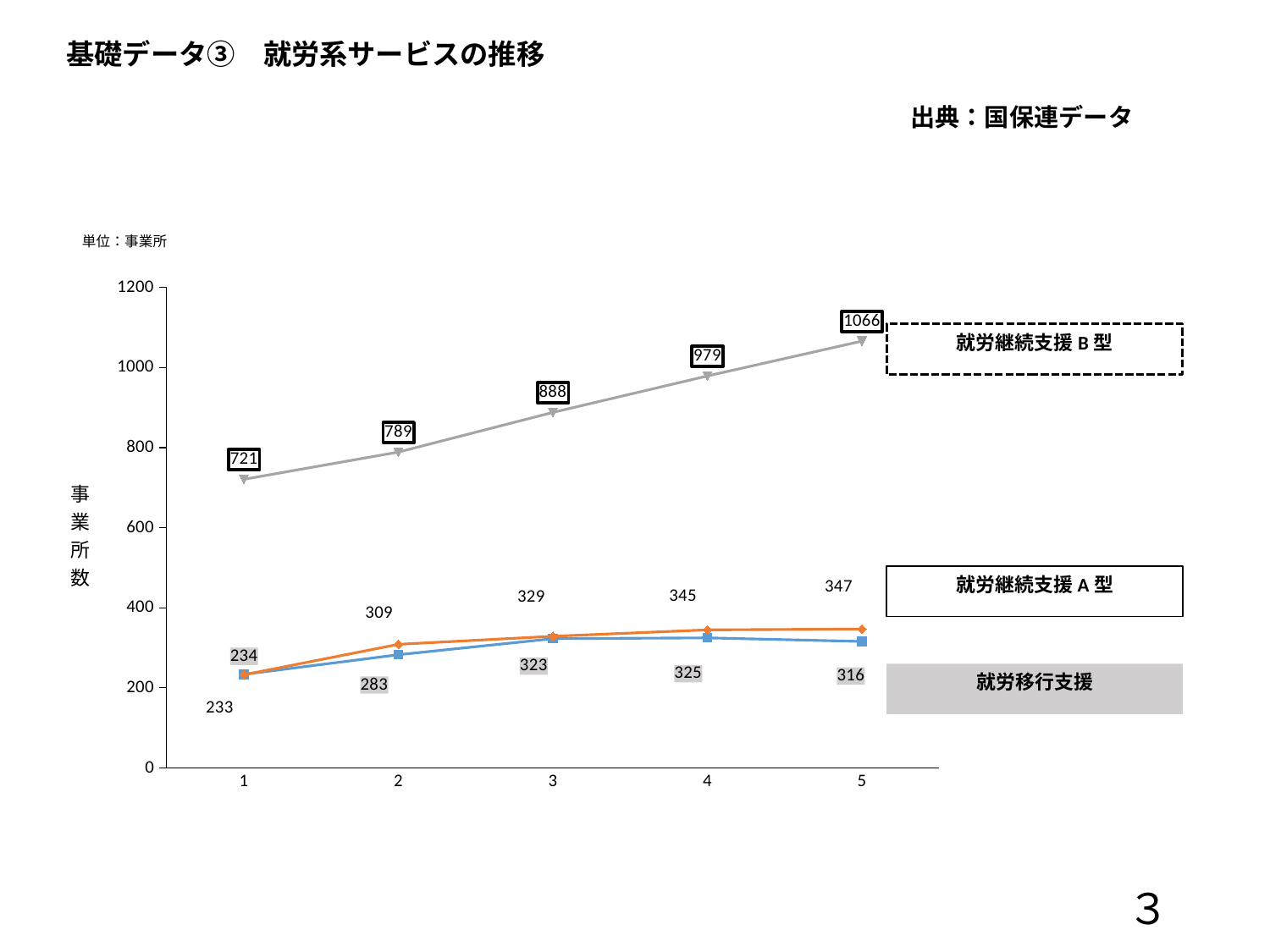
What is the difference between the 就労継続支援B型 values at point 5 and point 1? 345 What is the value for 就労継続支援A型 at point 4? 345 How many points are plotted along the x axis for each series? 5 Does 就労継続支援B型 rise or fall from point 1 to point 5? rise Which is larger at point 5: 就労継続支援A型 or 就労移行支援? 就労継続支援A型 What is the value for 就労継続支援B型 at point 5? 1066 What is the value for 就労移行支援 at point 2? 283 What is the value for 就労継続支援B型 at point 1? 721 What type of chart is shown on the slide? line chart At which point is 就労移行支援 lowest? 1 At which point is 就労継続支援B型 highest? 5 What unit is stated for the values in the chart? 事業所